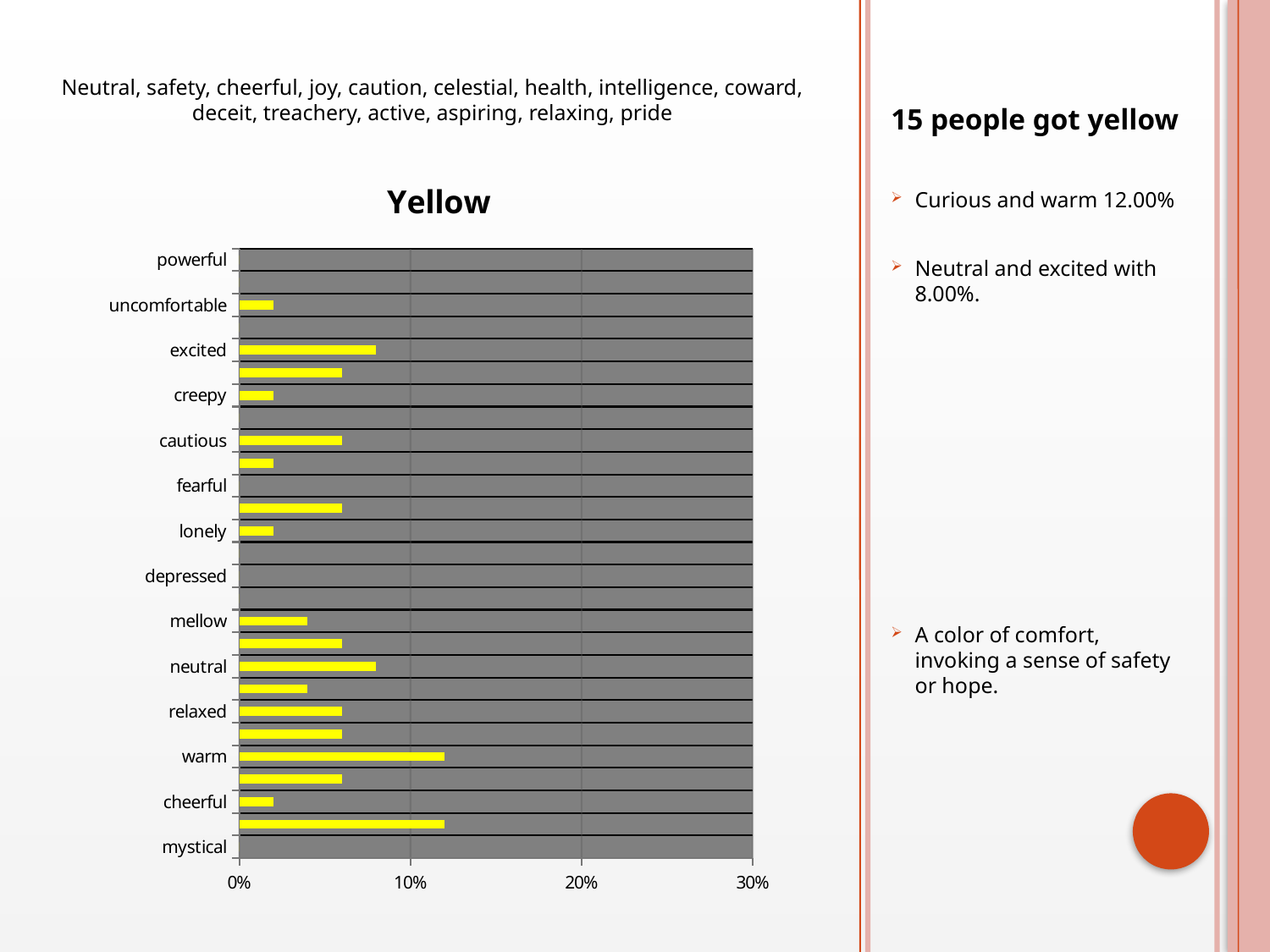
What is the highest value shown on the chart's percentage axis? 30% Which has the larger value, excited or creepy? excited Which has the larger value, warm or excited? warm Which has the larger value, neutral or mellow? neutral Is the value for mellow greater or less than 10%? less Is the value for neutral greater or less than 10%? less Is the value for warm greater or less than 10%? greater What is the title of the chart? Yellow What kind of chart is shown on the slide? bar chart